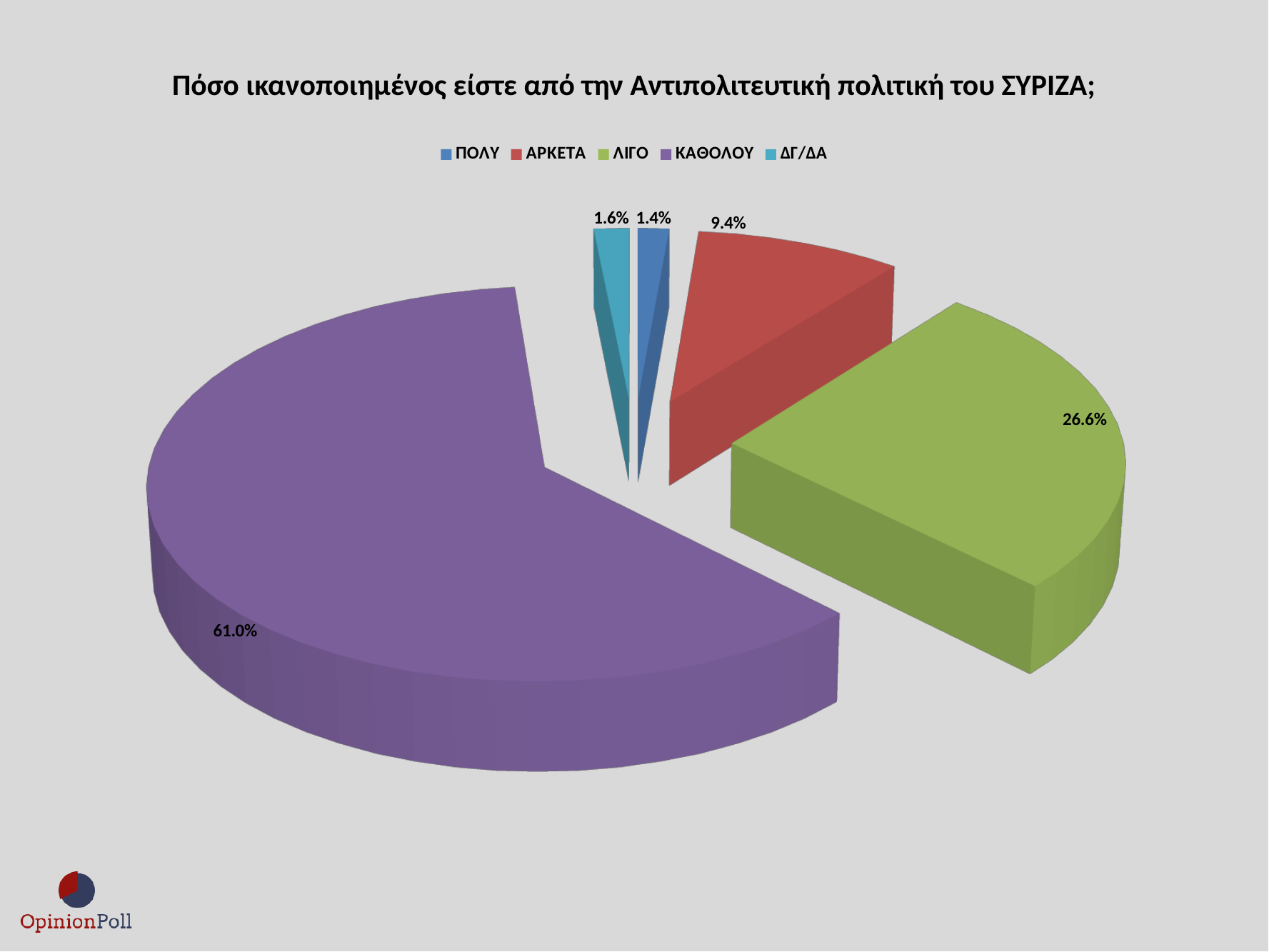
What colour represents ΚΑΘΟΛΟΥ in the chart? Purple Which is larger, the share for ΑΡΚΕΤΑ or the share for ΛΙΓΟ? ΛΙΓΟ Which response category has the largest share of the pie? ΚΑΘΟΛΟΥ What percentage of respondents answered ΔΓ/ΔΑ? 1.6% What kind of chart is shown on the slide? Pie chart What percentage of respondents answered ΠΟΛΥ? 1.4% Which response category has the smallest share of the pie? ΠΟΛΥ What percentage of respondents answered ΚΑΘΟΛΟΥ? 61.0% How many categories does the legend list? 5 What percentage of respondents answered ΑΡΚΕΤΑ? 9.4% What is the difference in percentage points between ΚΑΘΟΛΟΥ and ΛΙΓΟ? 34.4 What percentage of respondents answered ΛΙΓΟ? 26.6%